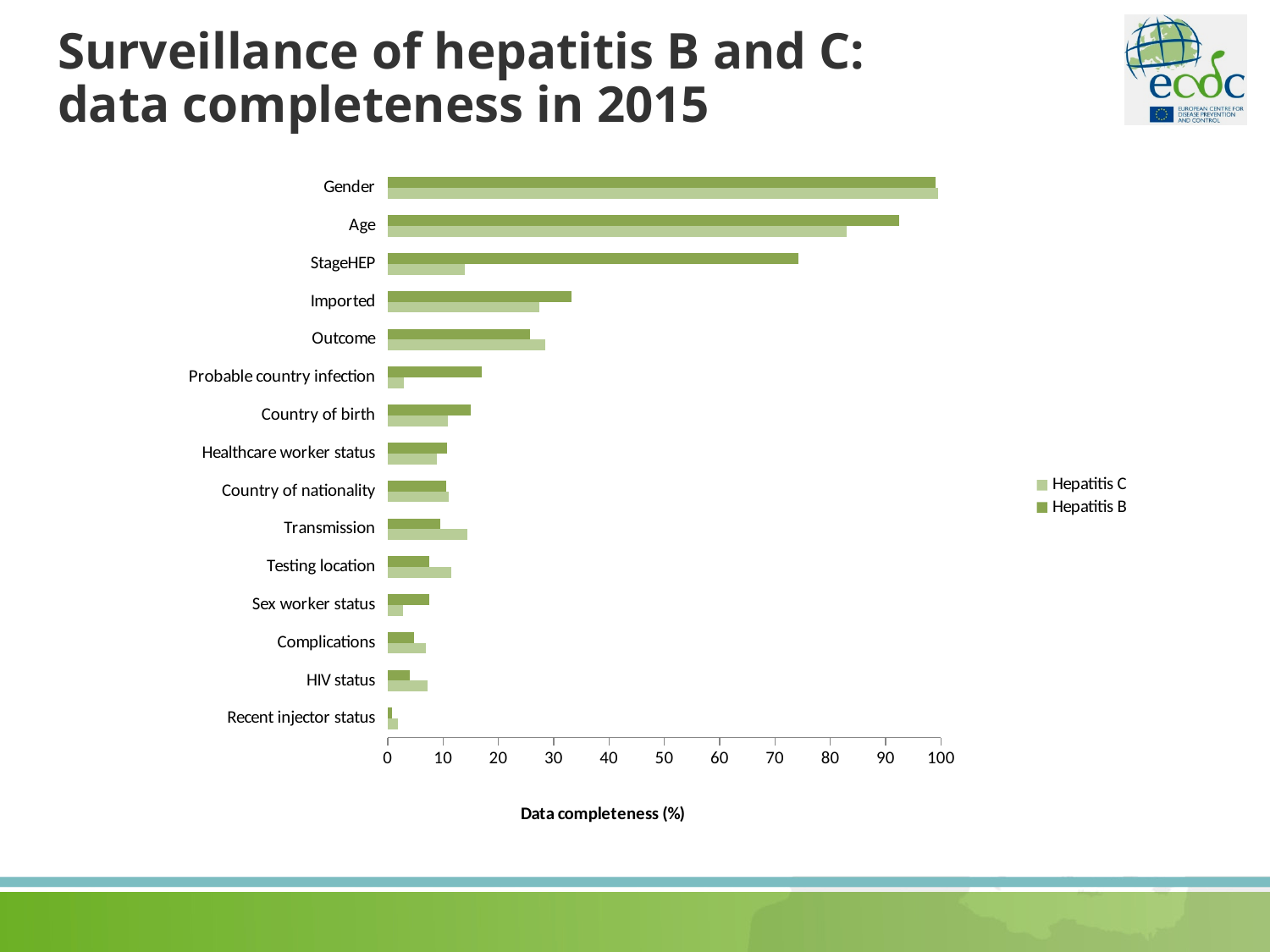
Which variable has the lowest data completeness for Hepatitis C? Recent injector status Which variable has the highest data completeness for Hepatitis B? Gender For StageHEP, which series has the higher data completeness, Hepatitis B or Hepatitis C? Hepatitis B How many series does the chart's legend list? 2 Which variable has the lowest data completeness for Hepatitis B? Recent injector status What kind of chart is shown on the slide? Bar chart What is the title of the horizontal axis of the chart? Data completeness (%) How many variables (categories) are listed on the vertical axis of the chart? 15 Is the Hepatitis B data completeness for Imported greater or less than 30? greater Is the Hepatitis B data completeness for StageHEP greater or less than 70? greater For Transmission, which series has the higher data completeness, Hepatitis B or Hepatitis C? Hepatitis C Is the Hepatitis C data completeness for Age greater or less than 90? less